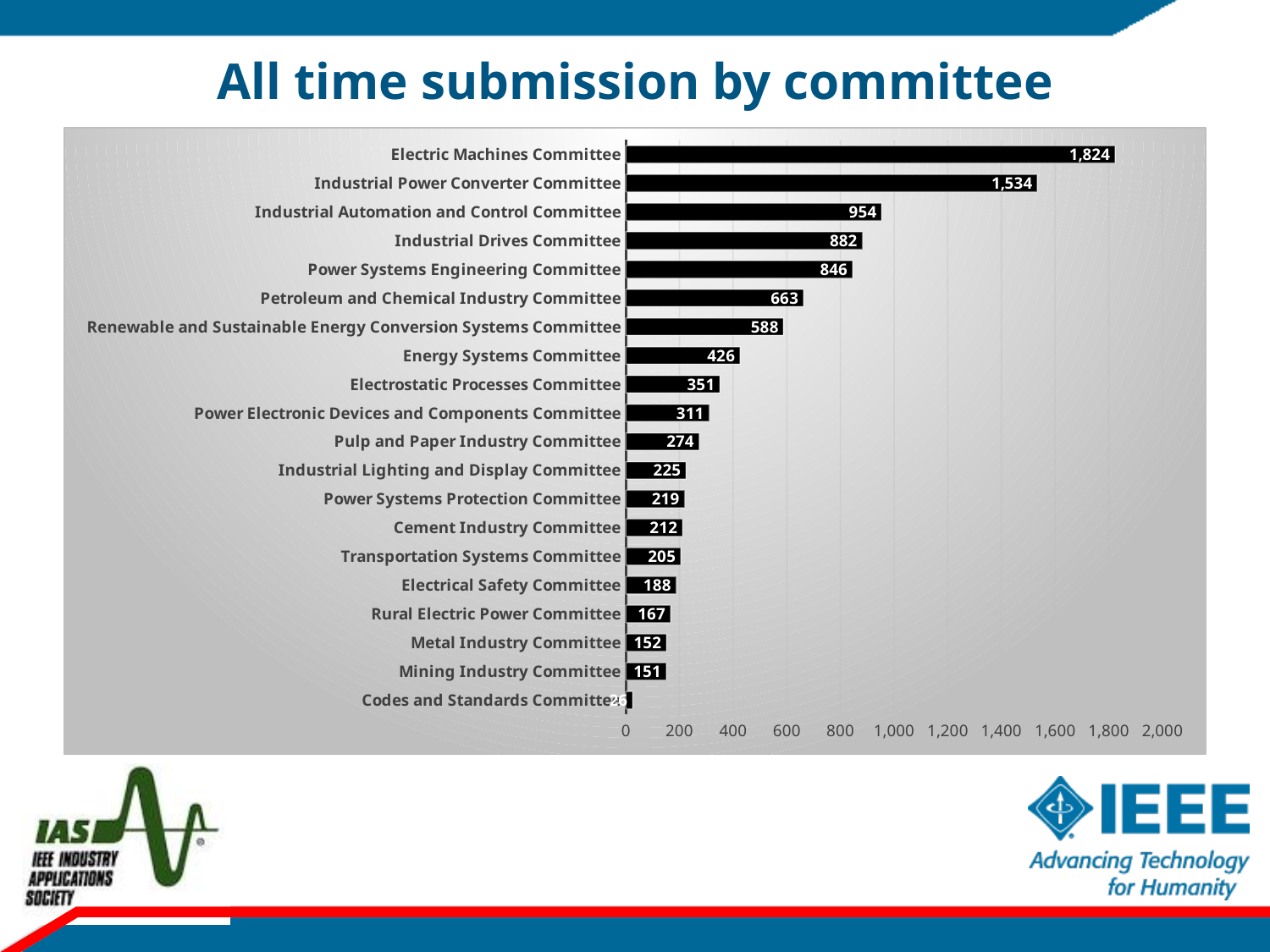
What type of chart is shown on the slide? bar chart What is the value shown for the Industrial Power Converter Committee? 1,534 What is the difference between the Industrial Drives Committee and the Power Systems Engineering Committee values? 36 Which has a larger value, the Energy Systems Committee or the Electrostatic Processes Committee? Energy Systems Committee What is the all-time submission count for the Electric Machines Committee? 1,824 What is the value shown for the Petroleum and Chemical Industry Committee? 663 What is the difference between the Electric Machines Committee and the Industrial Power Converter Committee values? 290 Which committee has the highest number of submissions? Electric Machines Committee Is the value for the Industrial Automation and Control Committee greater or less than 1,000? less How many committees are shown in the chart? 20 What is the value shown for the Mining Industry Committee? 151 Which committee has the lowest number of submissions? Codes and Standards Committee